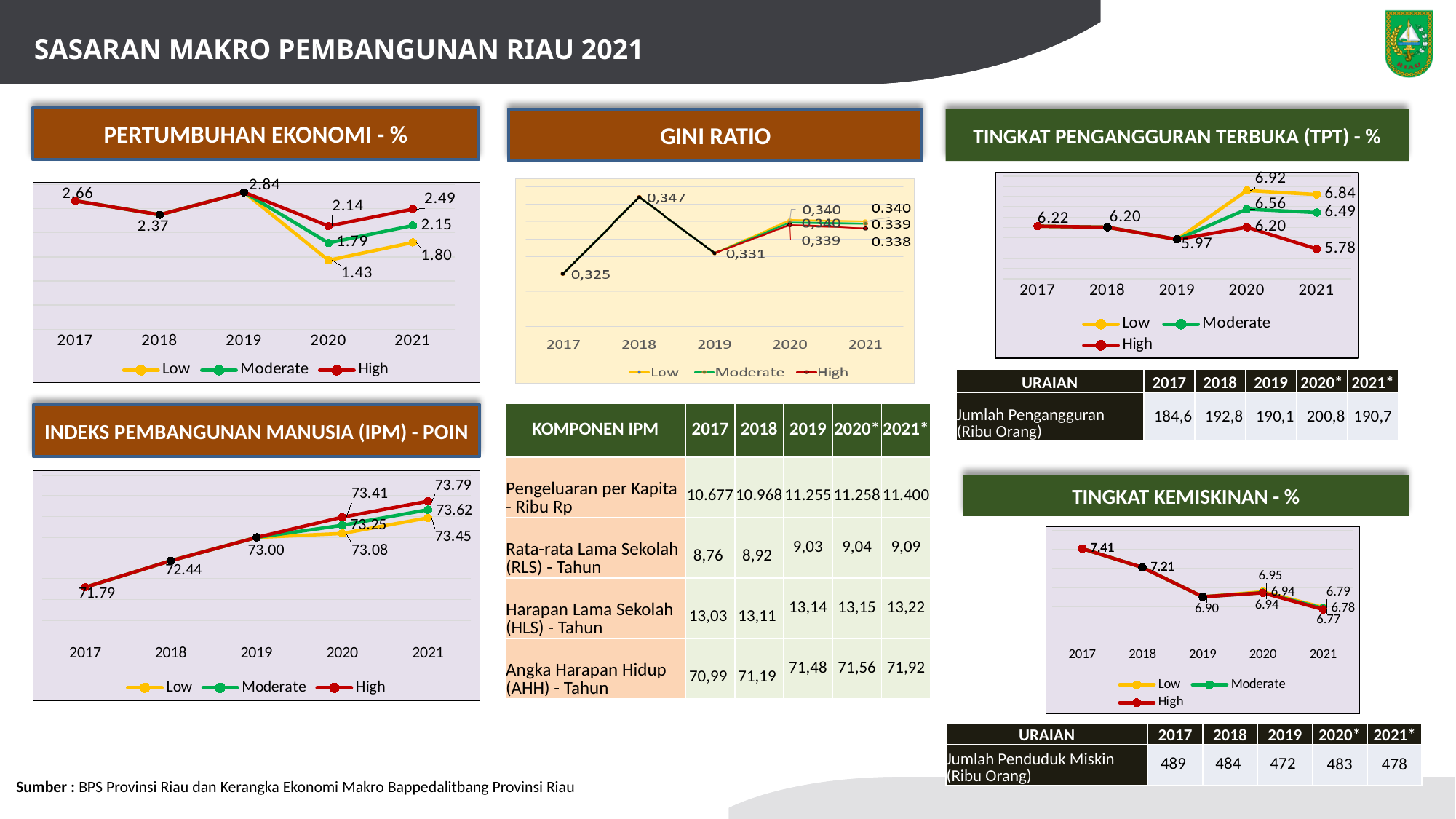
In the TINGKAT KEMISKINAN - % chart, what is the value for 2017? 7.41 In the INDEKS PEMBANGUNAN MANUSIA (IPM) - POIN chart, what is the High series value for 2021? 73.79 In the GINI RATIO chart, which year has the highest value? 2018 In the INDEKS PEMBANGUNAN MANUSIA (IPM) - POIN chart, do the values rise or fall from 2017 to 2019? rise In the PERTUMBUHAN EKONOMI - % chart, what is the value for 2019? 2.84 In the PERTUMBUHAN EKONOMI - % chart, what is the Low series value for 2020? 1.43 In the TINGKAT PENGANGGURAN TERBUKA (TPT) - % chart, what is the Low series value for 2020? 6.92 In the PERTUMBUHAN EKONOMI - % chart, what is the difference between the High and Low values for 2021? 0.69 How many series does the legend of the TINGKAT KEMISKINAN - % chart list? 3 What kind of chart is the PERTUMBUHAN EKONOMI - % chart? line chart In the TINGKAT PENGANGGURAN TERBUKA (TPT) - % chart, which is larger for 2021: the Moderate value or the High value? Moderate In the GINI RATIO chart, what is the value for 2017? 0,325